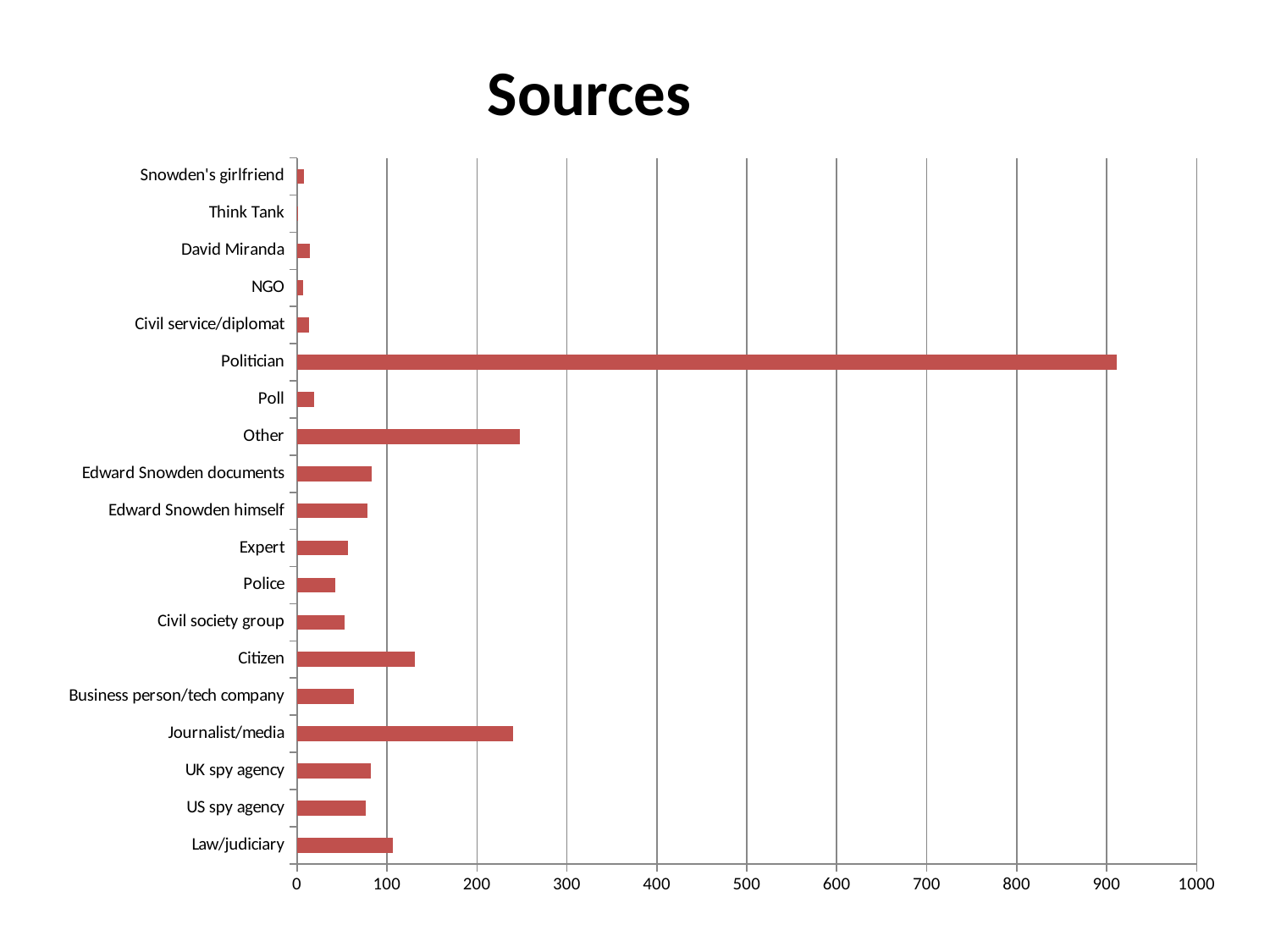
Is the value for Citizen greater or less than 100? greater Which is larger, the value for Politician or the value for Other? Politician Is the value for Poll greater or less than 100? less How many categories are plotted on the chart? 19 Which category has the highest value? Politician Which category has the lowest value? Think Tank What kind of chart is shown on the slide? bar chart What is the maximum value shown on the horizontal axis? 1000 Is the value for Politician greater or less than 800? greater What is the title of the chart? Sources Which is larger, the value for Citizen or the value for Police? Citizen